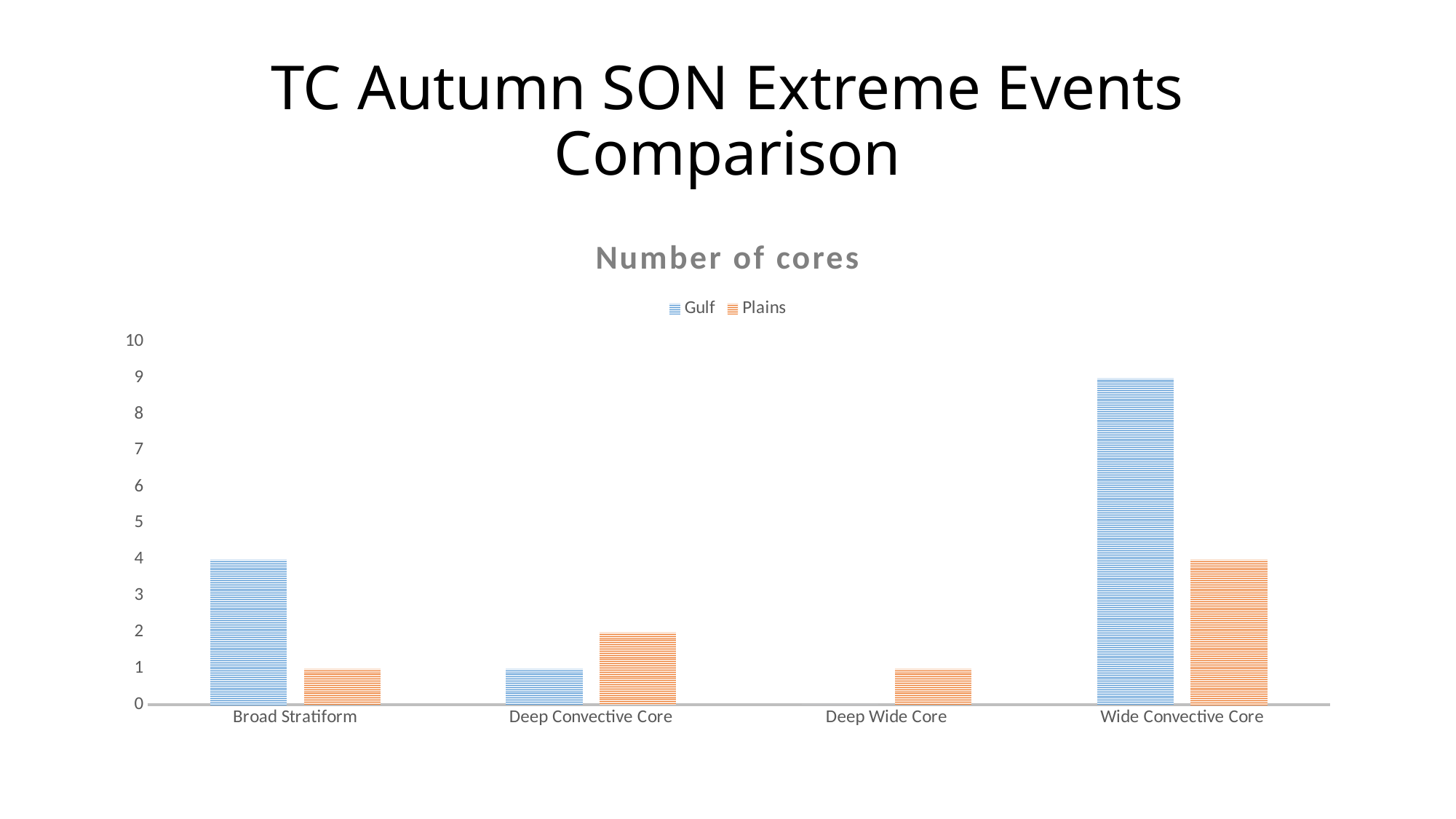
How many categories are shown on the x axis? 4 For Deep Convective Core, which series has the larger value, Gulf or Plains? Plains What is the title of the chart? Number of cores What is the Gulf value for Wide Convective Core? 9 What is the difference between the Gulf and Plains values for Wide Convective Core? 5 What is the Gulf value for Broad Stratiform? 4 What is the Plains value for Deep Convective Core? 2 How many series does the legend list? 2 Is the Gulf value for Wide Convective Core greater or less than 5? greater What type of chart is shown on the slide? bar chart Which category has the highest Gulf value? Wide Convective Core Which category has the lowest Gulf value? Deep Wide Core